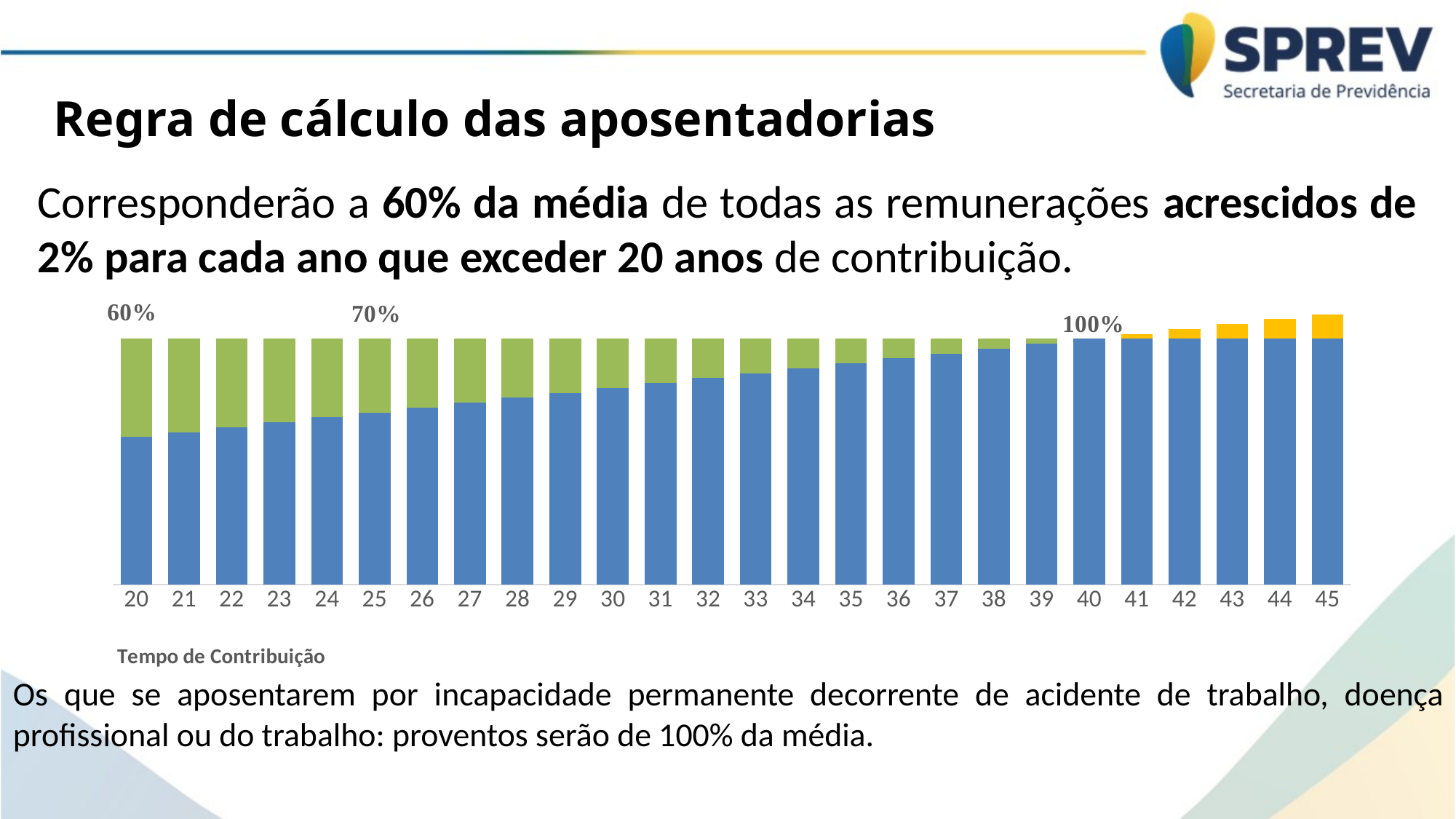
What kind of chart is shown on the slide? Stacked bar chart What value is labelled on the bar for 25 years of contribution? 70% What is the title of the x axis of the chart? Tempo de Contribuição What value is labelled on the bar for 40 years of contribution? 100% Do the blue bars rise or fall as the years of contribution increase from 20 to 40? Rise What is the difference between the labelled value at 25 years and the labelled value at 20 years of contribution? 10 percentage points What value is labelled on the bar for 20 years of contribution? 60% How many contribution-time categories are shown on the x axis of the chart? 26 Which has a taller blue bar: 20 years or 35 years of contribution? 35 Which contribution-time category has the shortest blue bar? 20 What is the difference between the labelled value at 40 years and the labelled value at 20 years of contribution? 40 percentage points What colour is the segment that appears on top of the bars from 41 to 45 years of contribution? Orange